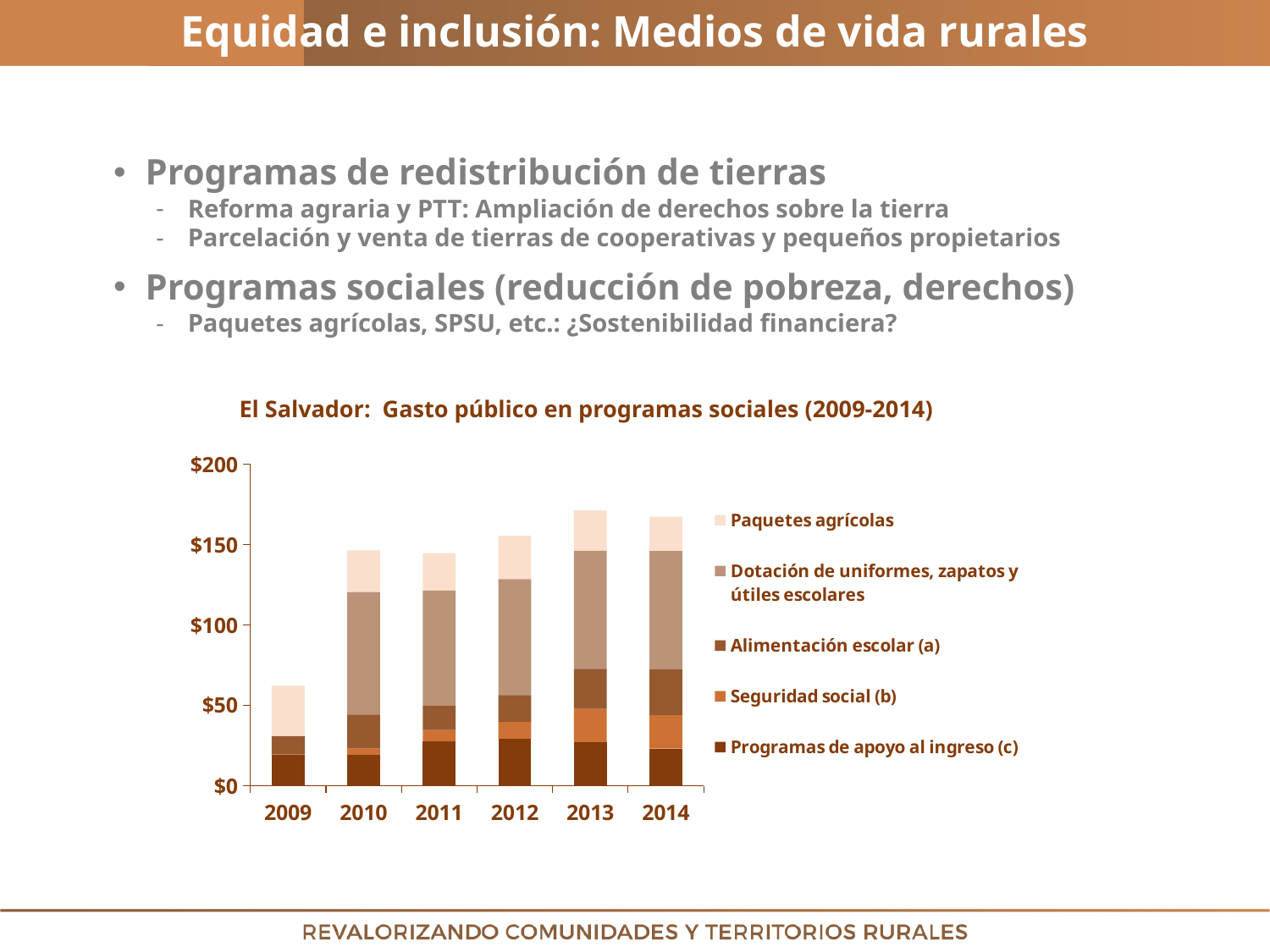
Is the total bar for 2010 greater or less than $100? greater What kind of chart is shown on the slide? Stacked bar chart Is the total bar for 2014 greater or less than $150? greater Which year has a larger total bar, 2009 or 2012? 2012 Is the total bar for 2013 greater or less than $150? greater Does total spending rise or fall from 2009 to 2010? rise How many series does the chart's legend list? 5 What is the title of the chart? El Salvador: Gasto público en programas sociales (2009-2014) How many years are shown on the x axis of the chart? 6 Which year has the lowest total public spending in the chart? 2009 Which series is shown at the bottom of each stacked bar? Programas de apoyo al ingreso (c)